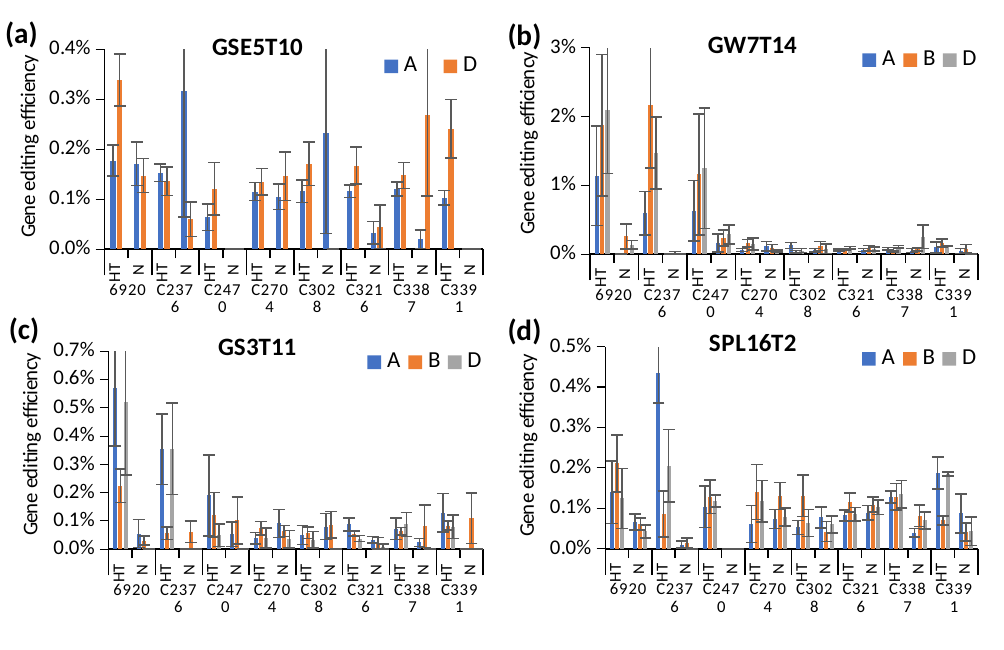
In the GS3T11 chart (panel c), is the value of series A for 6920 HT greater or less than 0.5%? greater What kind of chart is the GSE5T10 chart in panel (a)? bar chart What is the title of the chart in panel (b)? GW7T14 What is the y-axis label of the SPL16T2 chart (panel d)? Gene editing efficiency How many series does the legend of the GW7T14 chart (panel b) list? 3 In the GSE5T10 chart (panel a), which series has the larger value for 6920 HT, A or D? D In the SPL16T2 chart (panel d), is the value of series A for C2376 HT greater or less than 0.3%? greater In the GW7T14 chart (panel b), is the value of series B for C2376 HT greater or less than 1%? greater How many series does the legend of the GSE5T10 chart (panel a) list? 2 In the SPL16T2 chart (panel d), which series and group has the highest bar? A at C2376 HT In the GSE5T10 chart (panel a), how many gene labels (e.g. 6920, C2376) are shown along the x axis? 8